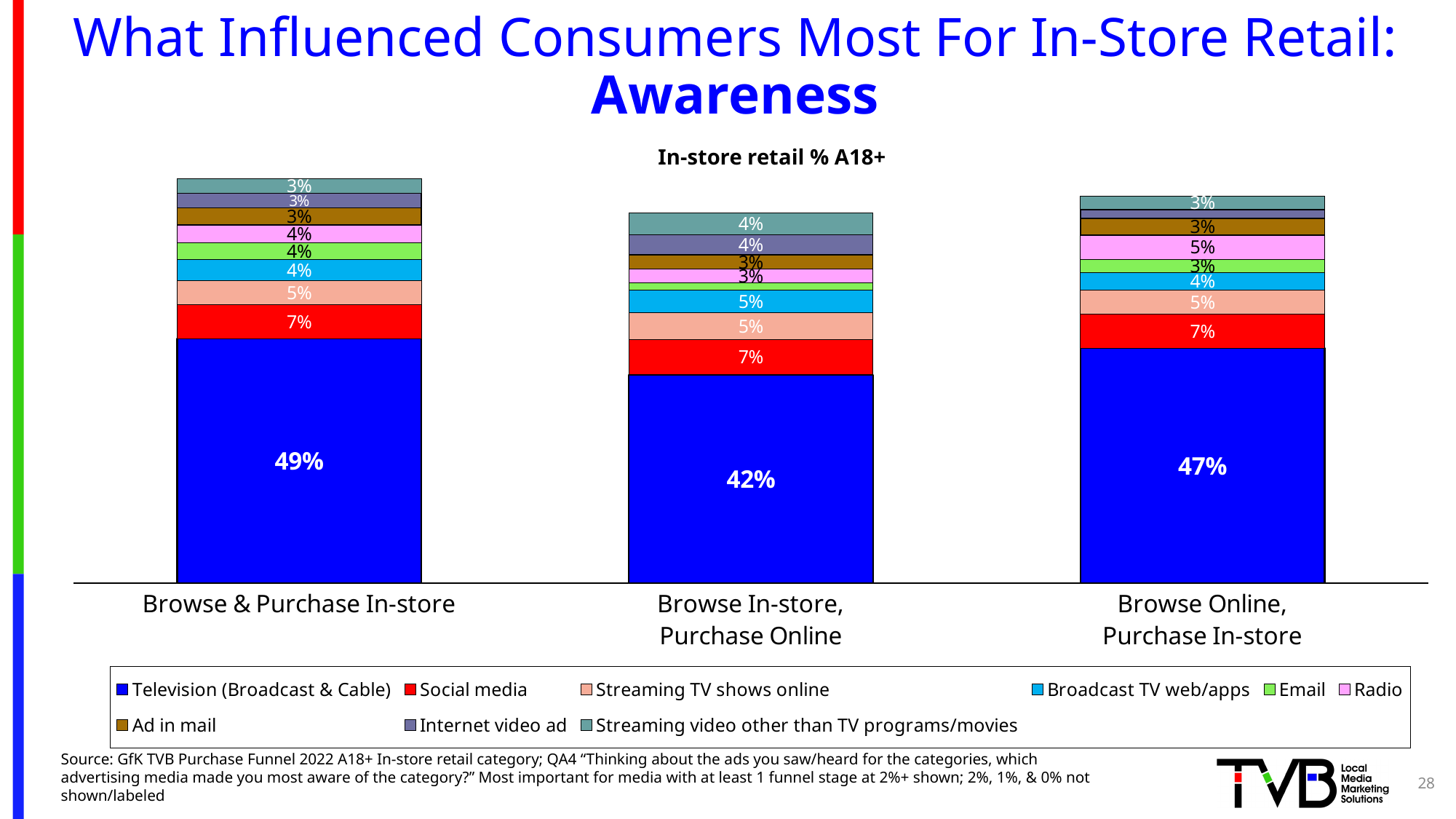
Which category has the highest Television (Broadcast & Cable) value? Browse & Purchase In-store Which has the larger Broadcast TV web/apps value: Browse & Purchase In-store or Browse In-store, Purchase Online? Browse In-store, Purchase Online What kind of chart is shown on the slide? Stacked bar chart What is the Television (Broadcast & Cable) value for Browse In-store, Purchase Online? 42% What is the Radio value for Browse Online, Purchase In-store? 5% What percentage does Television (Broadcast & Cable) account for in the Browse & Purchase In-store bar? 49% Which category has the lowest Television (Broadcast & Cable) value? Browse In-store, Purchase Online How many categories are shown on the x axis? 3 What is the Social media value for Browse Online, Purchase In-store? 7% What is the difference between the Television (Broadcast & Cable) values for Browse & Purchase In-store and Browse In-store, Purchase Online? 7 percentage points How many series does the legend list? 9 What is the value for Streaming video other than TV programs/movies in the Browse In-store, Purchase Online bar? 4%